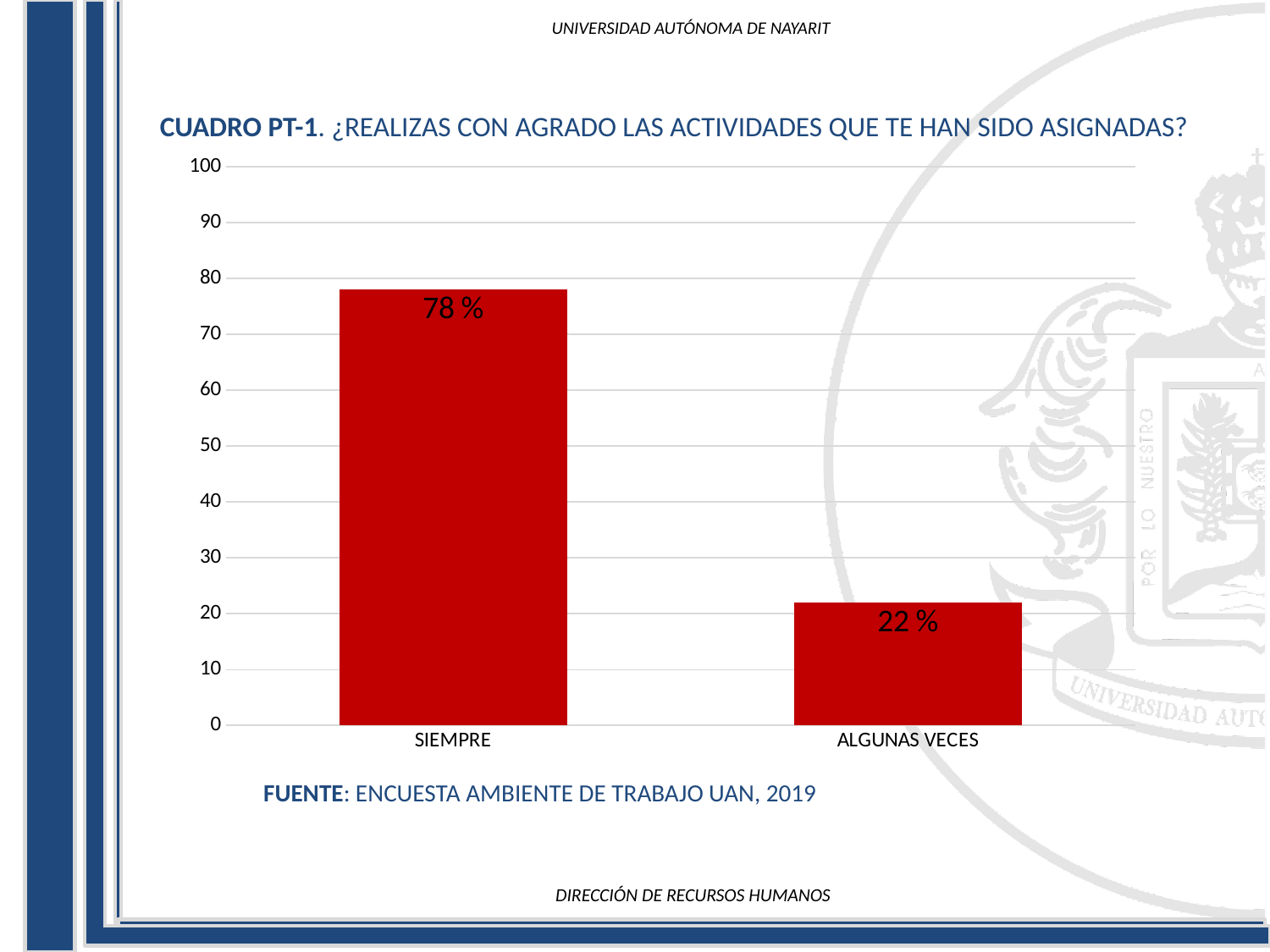
What is the difference between the values for SIEMPRE and ALGUNAS VECES? 56 % What is the total of the two values shown in the chart? 100 % What is the value for SIEMPRE? 78 % Which is larger, the value for SIEMPRE or the value for ALGUNAS VECES? SIEMPRE What kind of chart is shown on the slide? bar chart Which category has the lowest value? ALGUNAS VECES What source is cited below the chart? ENCUESTA AMBIENTE DE TRABAJO UAN, 2019 Is the value for ALGUNAS VECES greater or less than 30? less What is the value for ALGUNAS VECES? 22 % Is the value for SIEMPRE greater or less than 70? greater Which category has the highest value? SIEMPRE How many categories are shown on the x axis? 2